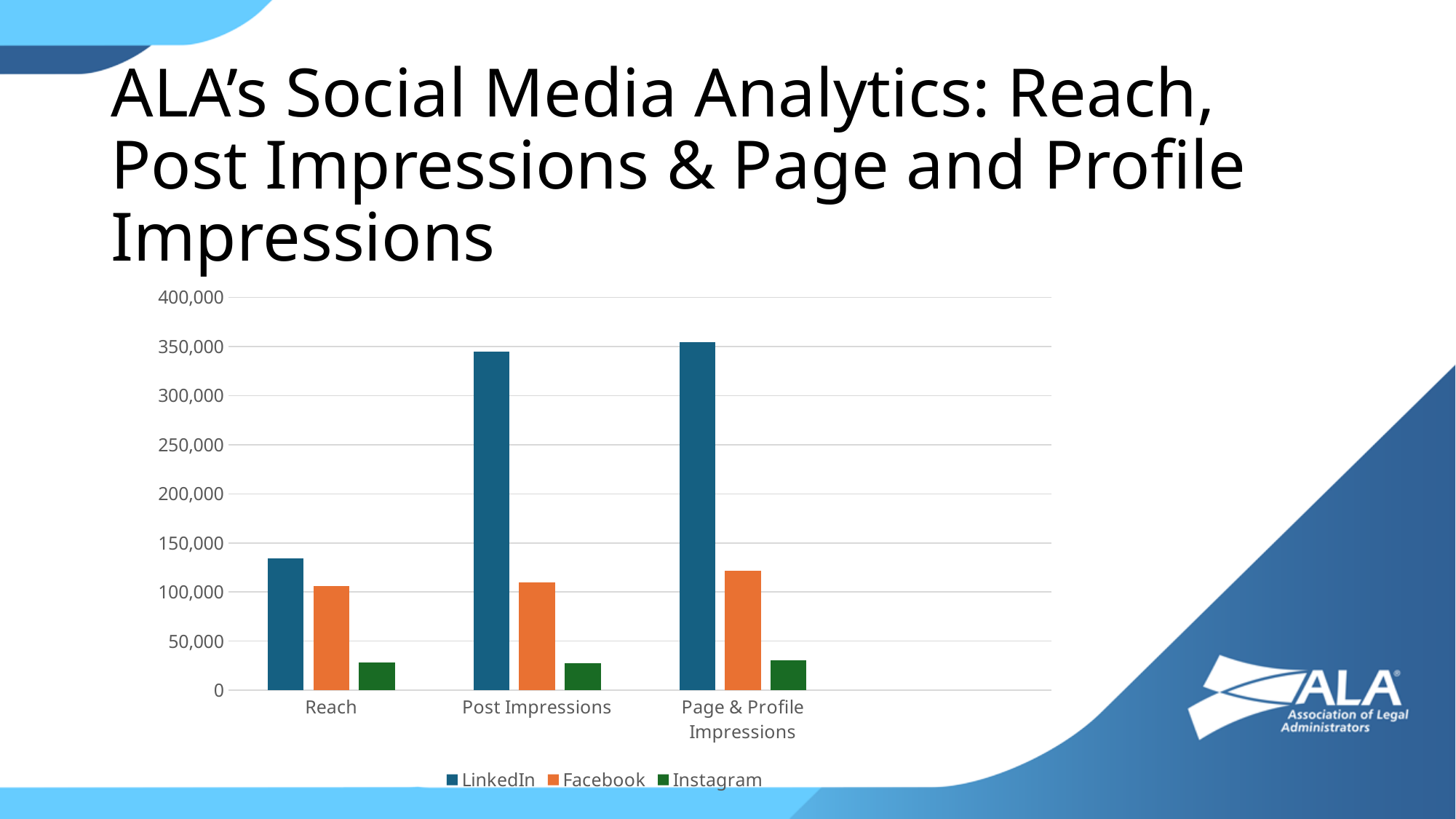
Is the LinkedIn value for Reach greater or less than 100,000? greater Is the Facebook value for Page & Profile Impressions greater or less than 100,000? greater What kind of chart is shown on the slide? bar chart Which series is represented by the orange bars? Facebook How many categories are shown on the x axis? 3 Which is larger for LinkedIn: Reach or Post Impressions? Post Impressions Which series has the lowest value in the Post Impressions category? Instagram How many series does the legend list? 3 Is the LinkedIn value for Post Impressions greater or less than 300,000? greater For Facebook, which category has the highest value? Page & Profile Impressions Which series has the highest value in the Reach category? LinkedIn